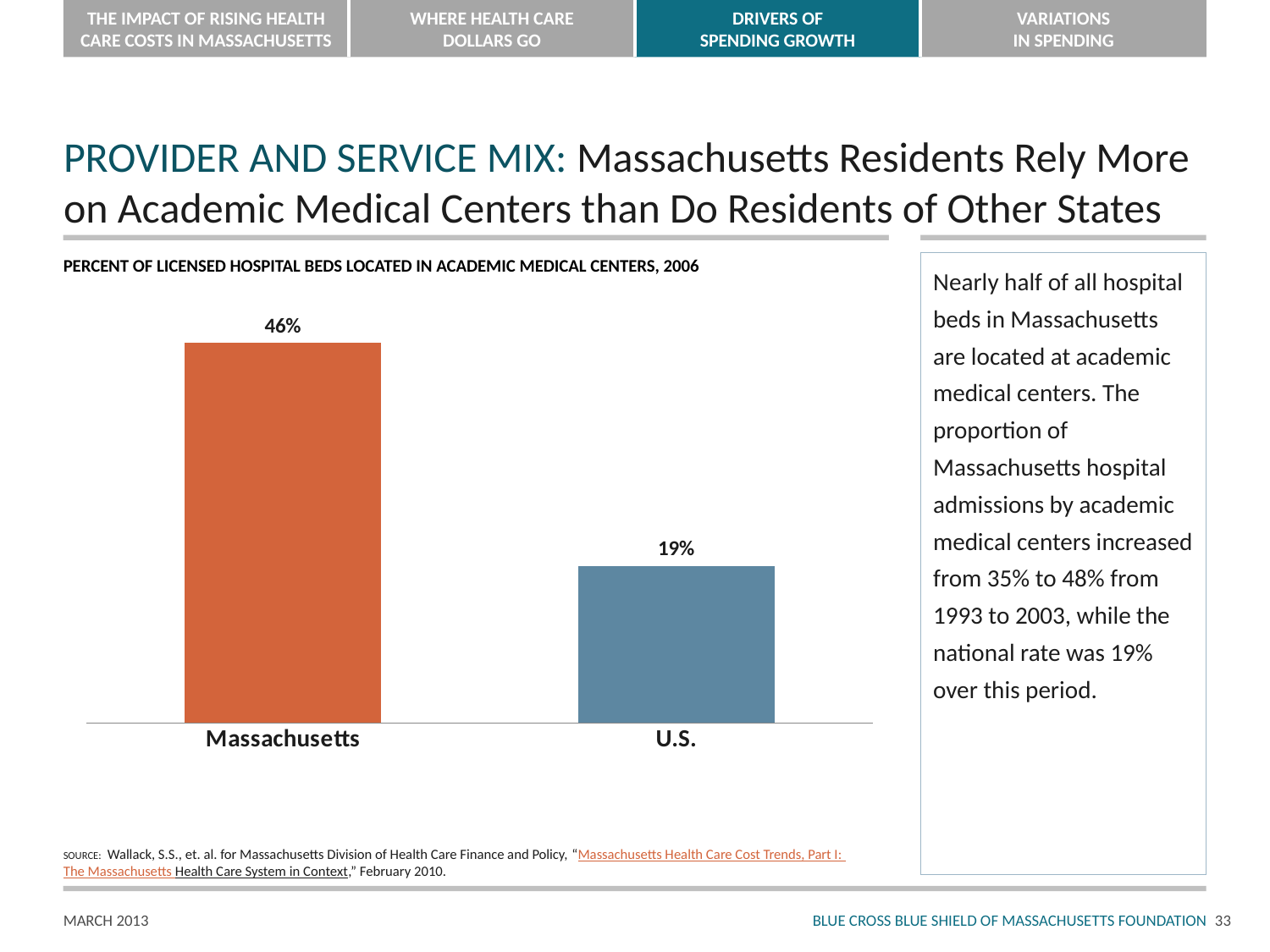
What is the title of the chart? Percent of Licensed Hospital Beds Located in Academic Medical Centers, 2006 How many categories are shown in the chart? 2 What is the difference between the values for Massachusetts and U.S.? 27% Which category has the highest value? Massachusetts Which category has the lowest value? U.S. What kind of chart is shown on the slide? Bar chart What colour is the bar for Massachusetts? Orange Which is larger, the value for Massachusetts or the value for U.S.? Massachusetts What is the value for U.S.? 19% What is the value for Massachusetts? 46%